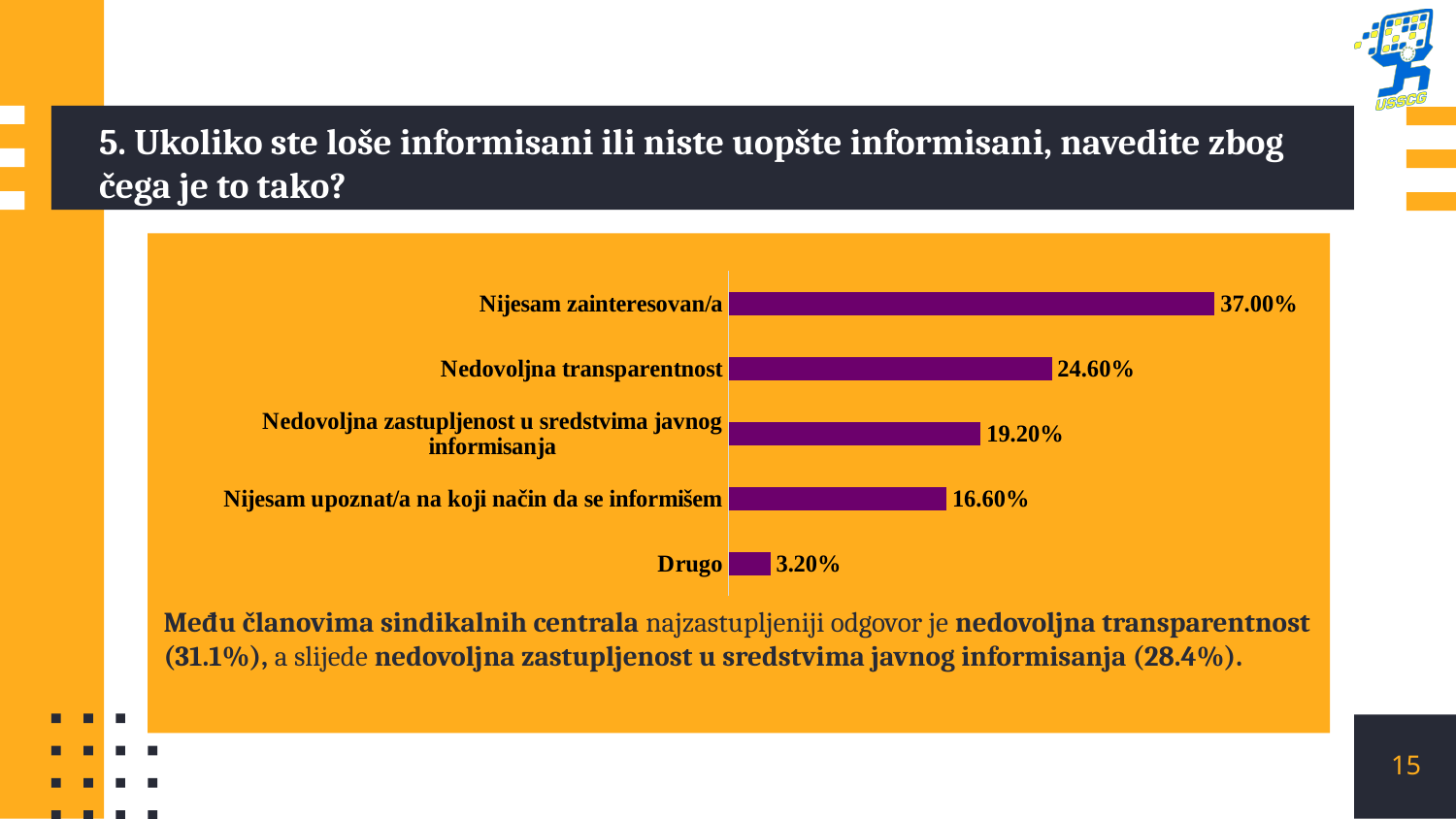
What kind of chart is shown on the slide? Bar chart What colour are the bars in the chart? Purple What is the value for "Nijesam zainteresovan/a"? 37.00% What is the value for "Nedovoljna zastupljenost u sredstvima javnog informisanja"? 19.20% What is the value for "Drugo"? 3.20% What is the difference between the values for "Nijesam zainteresovan/a" and "Nedovoljna transparentnost"? 12.40% Which is larger: the value for "Nedovoljna zastupljenost u sredstvima javnog informisanja" or the value for "Nijesam upoznat/a na koji način da se informišem"? Nedovoljna zastupljenost u sredstvima javnog informisanja What is the value for "Nedovoljna transparentnost"? 24.60% Which category has the highest value? Nijesam zainteresovan/a Which category has the lowest value? Drugo What is the value for "Nijesam upoznat/a na koji način da se informišem"? 16.60% How many categories are shown in the chart? 5